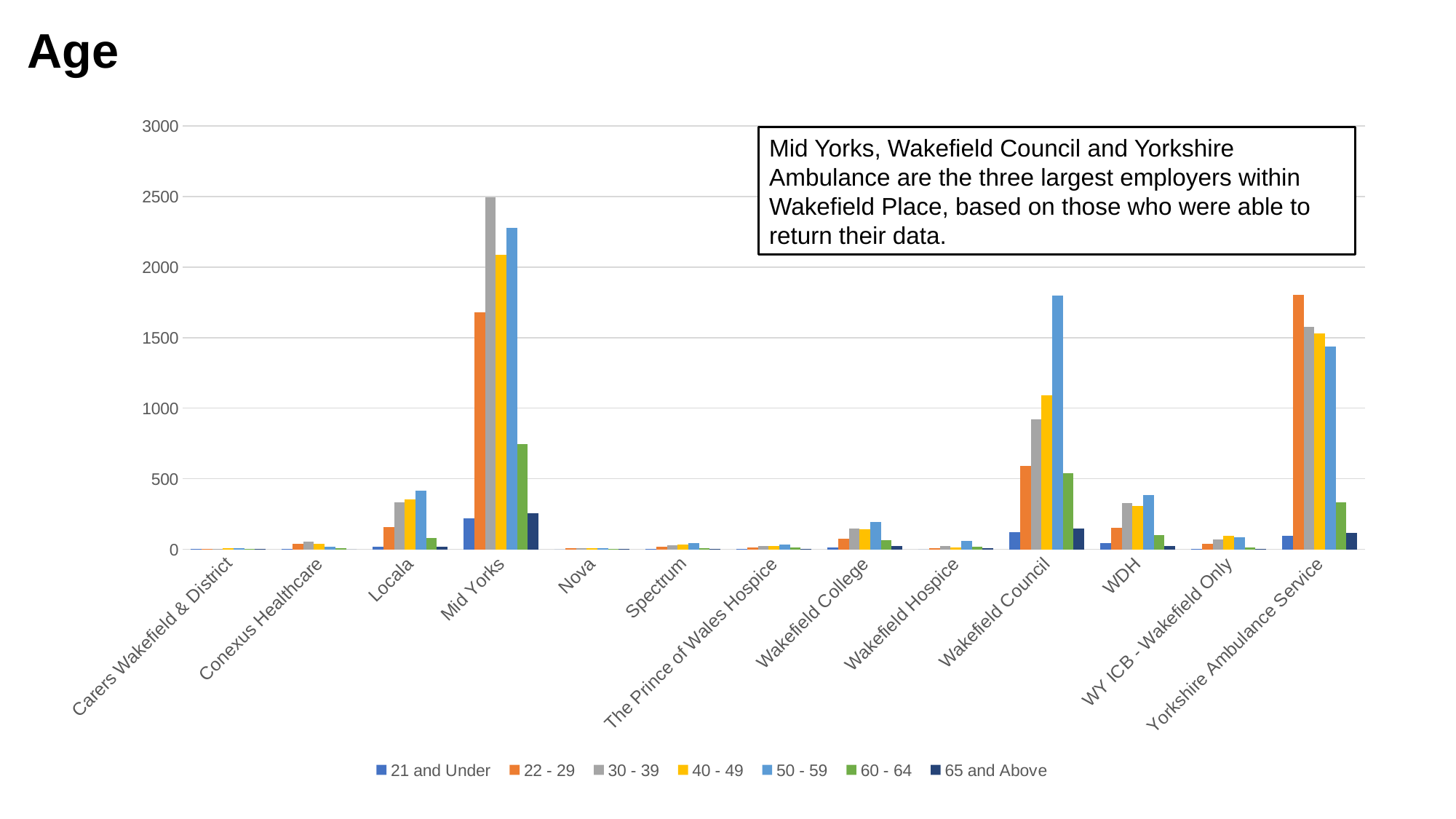
For Mid Yorks, which age group has the highest bar? 30 - 39 Which is larger: the 50 - 59 bar for Mid Yorks or the 50 - 59 bar for Wakefield Council? Mid Yorks What is the title of the slide? Age Is the value for the 50 - 59 group at Mid Yorks greater or less than 2000? greater Is the value for the 50 - 59 group at Locala greater or less than 500? less For Wakefield Council, which age group has the highest bar? 50 - 59 Is the value for the 50 - 59 group at Wakefield Council greater or less than 1500? greater What kind of chart is shown on the slide? bar chart For Yorkshire Ambulance Service, which age group has the highest bar? 22 - 29 How many employers (categories) are shown on the x axis? 13 How many series does the legend list? 7